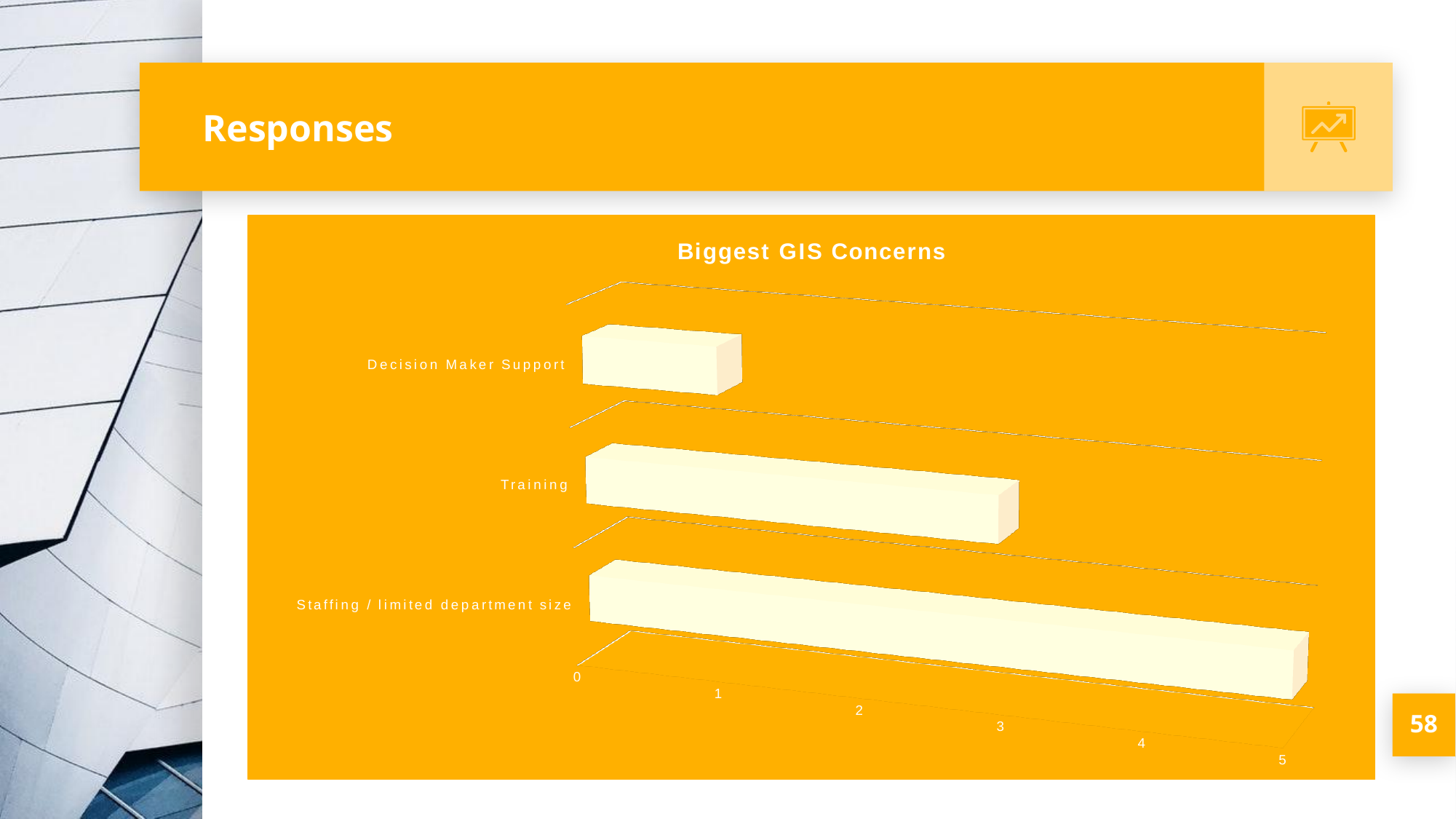
Is the value for Staffing / limited department size greater or less than 4? greater Is the value for Decision Maker Support greater or less than 2? less What is the highest tick value shown on the value axis of the chart? 5 What is the title of the chart? Biggest GIS Concerns Is the value for Training greater or less than 2? greater Which is larger, the value for Training or the value for Decision Maker Support? Training Which category has the highest value in the Biggest GIS Concerns chart? Staffing / limited department size Which category has the lowest value in the Biggest GIS Concerns chart? Decision Maker Support What kind of chart is shown on the slide? bar chart Which is larger, the value for Staffing / limited department size or the value for Training? Staffing / limited department size How many categories are plotted in the Biggest GIS Concerns chart? 3